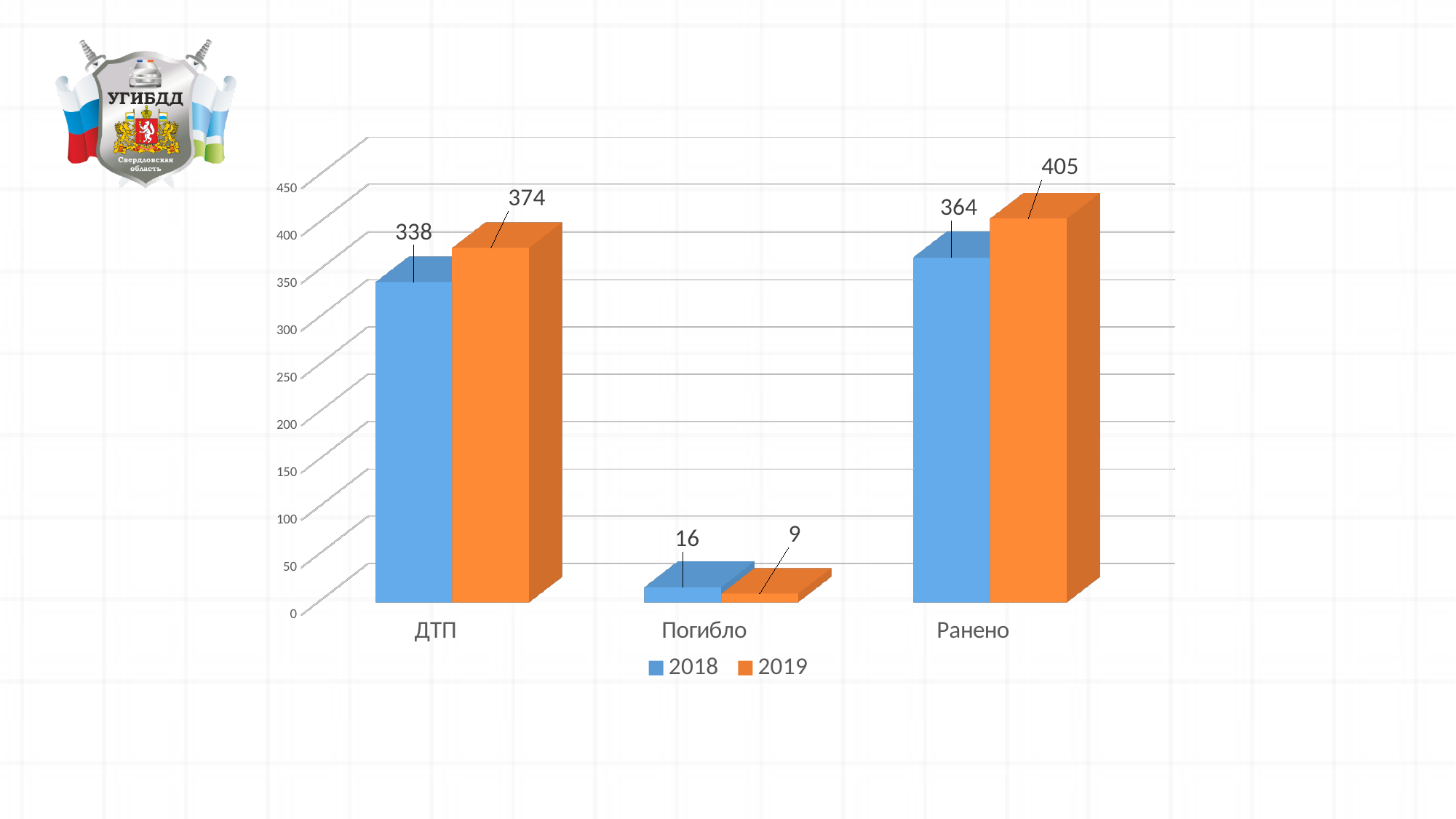
Which is larger for Погибло: the 2018 value or the 2019 value? 2018 Which category has the highest value in 2019? Ранено What kind of chart is shown on the slide? Bar chart What is the difference between the 2019 and 2018 values for Ранено? 41 What is the value for ДТП in 2018? 338 What is the value for Погибло in 2018? 16 Which category has the lowest value in 2018? Погибло What is the difference between the 2019 and 2018 values for ДТП? 36 How many series does the legend list? 2 What is the value for Погибло in 2019? 9 How many categories are shown on the x axis? 3 What is the value for Ранено in 2019? 405